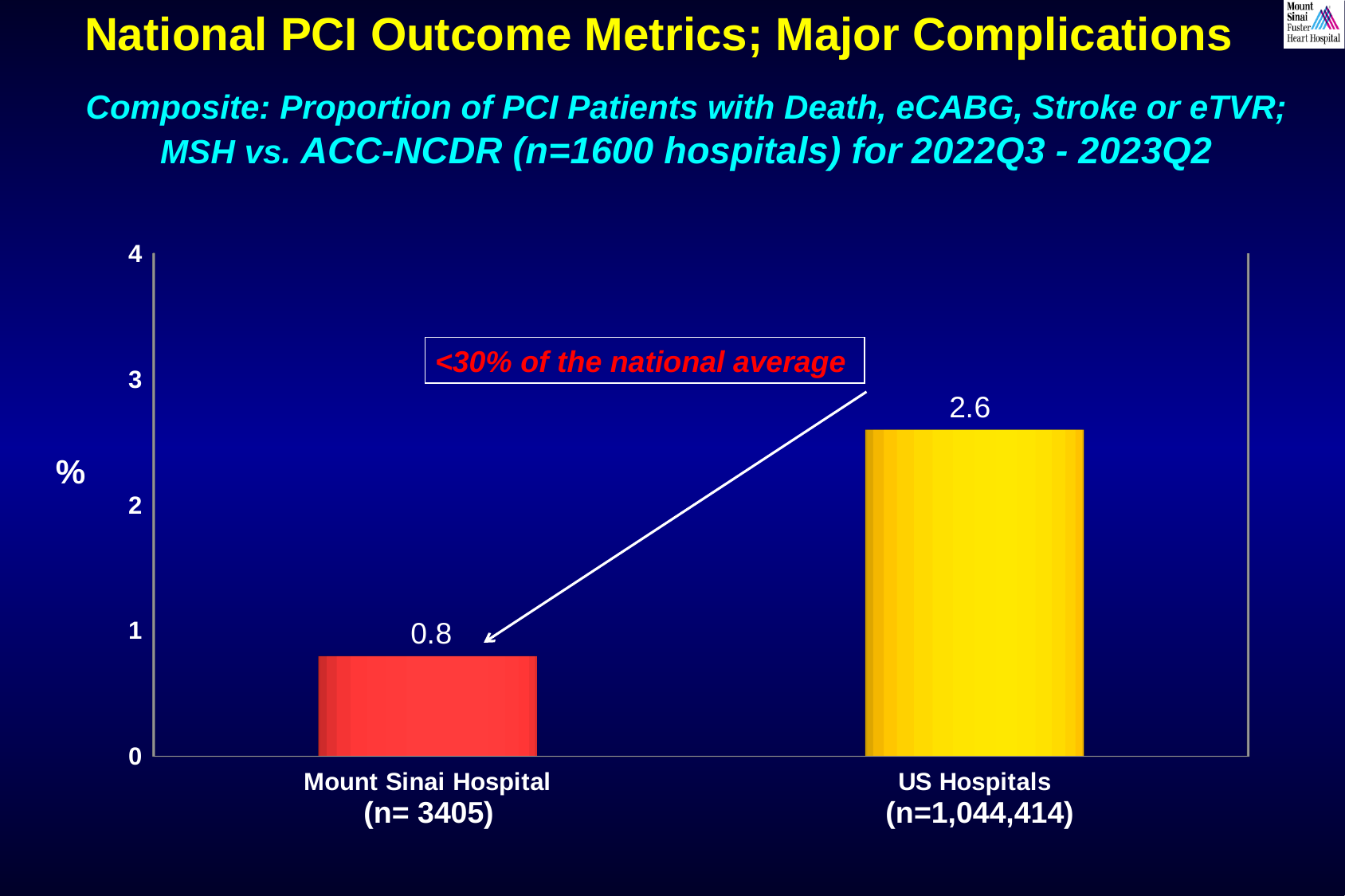
Which category has the lowest value? Mount Sinai Hospital What is the label on the vertical axis of the chart? % What is the value for US Hospitals? 2.6 Which category has the highest value? US Hospitals Is the value for Mount Sinai Hospital greater or less than 1? less What kind of chart is shown on the slide? Bar chart What is the value for Mount Sinai Hospital? 0.8 How many categories are shown on the chart? 2 Which is larger, the value for Mount Sinai Hospital or the value for US Hospitals? US Hospitals What does the text in the box on the chart say? <30% of the national average Is the value for US Hospitals greater or less than 2? greater What is the difference between the US Hospitals value and the Mount Sinai Hospital value? 1.8